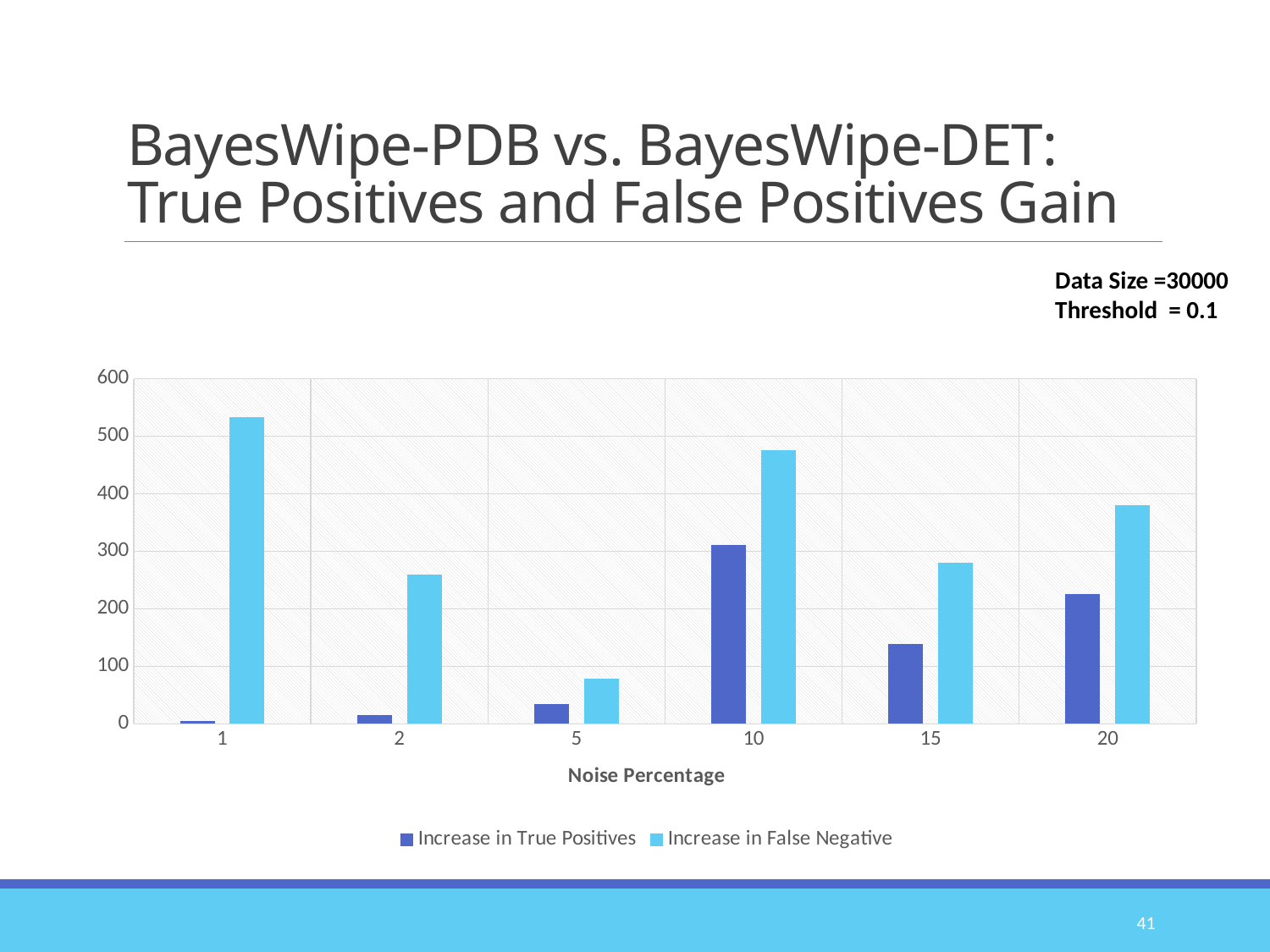
How many series does the legend list? 2 At noise percentage 10, which series has the larger value: Increase in True Positives or Increase in False Negative? Increase in False Negative How many noise percentage categories are plotted on the x axis? 6 Is the Increase in True Positives larger at noise percentage 20 or at noise percentage 15? 20 At which noise percentage is the Increase in False Negative highest? 1 What kind of chart is shown on the slide? bar chart Is the Increase in True Positives at noise percentage 15 greater or less than 200? less Is the Increase in False Negative at noise percentage 1 greater or less than 500? greater At which noise percentage is the Increase in True Positives highest? 10 At which noise percentage is the Increase in False Negative lowest? 5 At which noise percentage is the Increase in True Positives lowest? 1 What is the title of the x axis? Noise Percentage